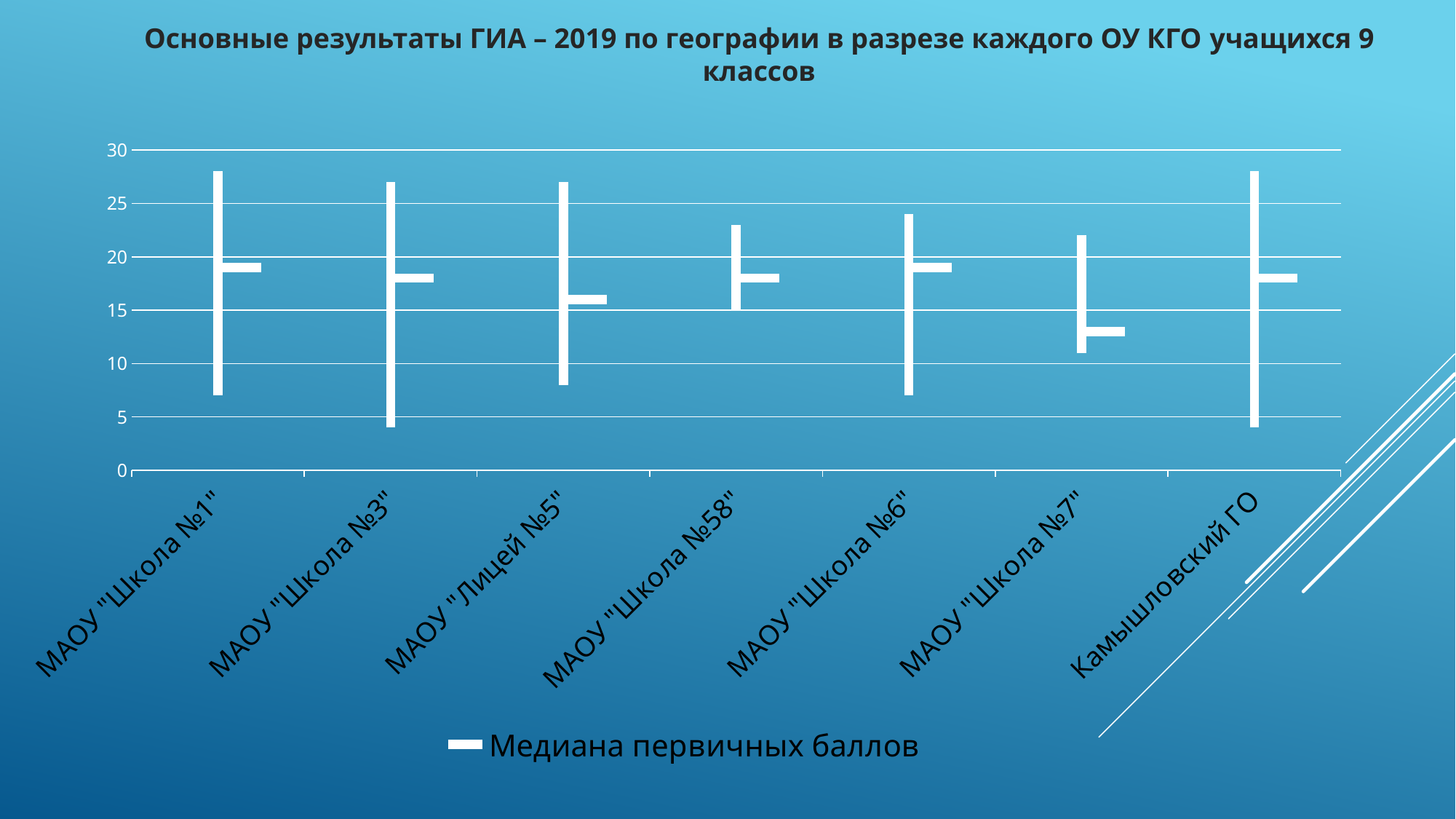
Which has the higher median primary score: МАОУ "Лицей №5" or МАОУ "Школа №7"? МАОУ "Лицей №5" What is the highest value shown on the vertical axis of the chart? 30 Is the median primary score for МАОУ "Лицей №5" greater or less than 15? greater Which school has the lowest median primary score in the chart? МАОУ "Школа №7" Is the median primary score for МАОУ "Школа №58" greater or less than 20? less Is the median primary score for Камышловский ГО greater or less than 15? greater How many schools (categories) are shown on the x axis of the chart? 7 Which has the higher median primary score: МАОУ "Школа №1" or МАОУ "Школа №7"? МАОУ "Школа №1" How many series does the chart legend list? 1 What is the name of the series shown in the chart legend? Медиана первичных баллов